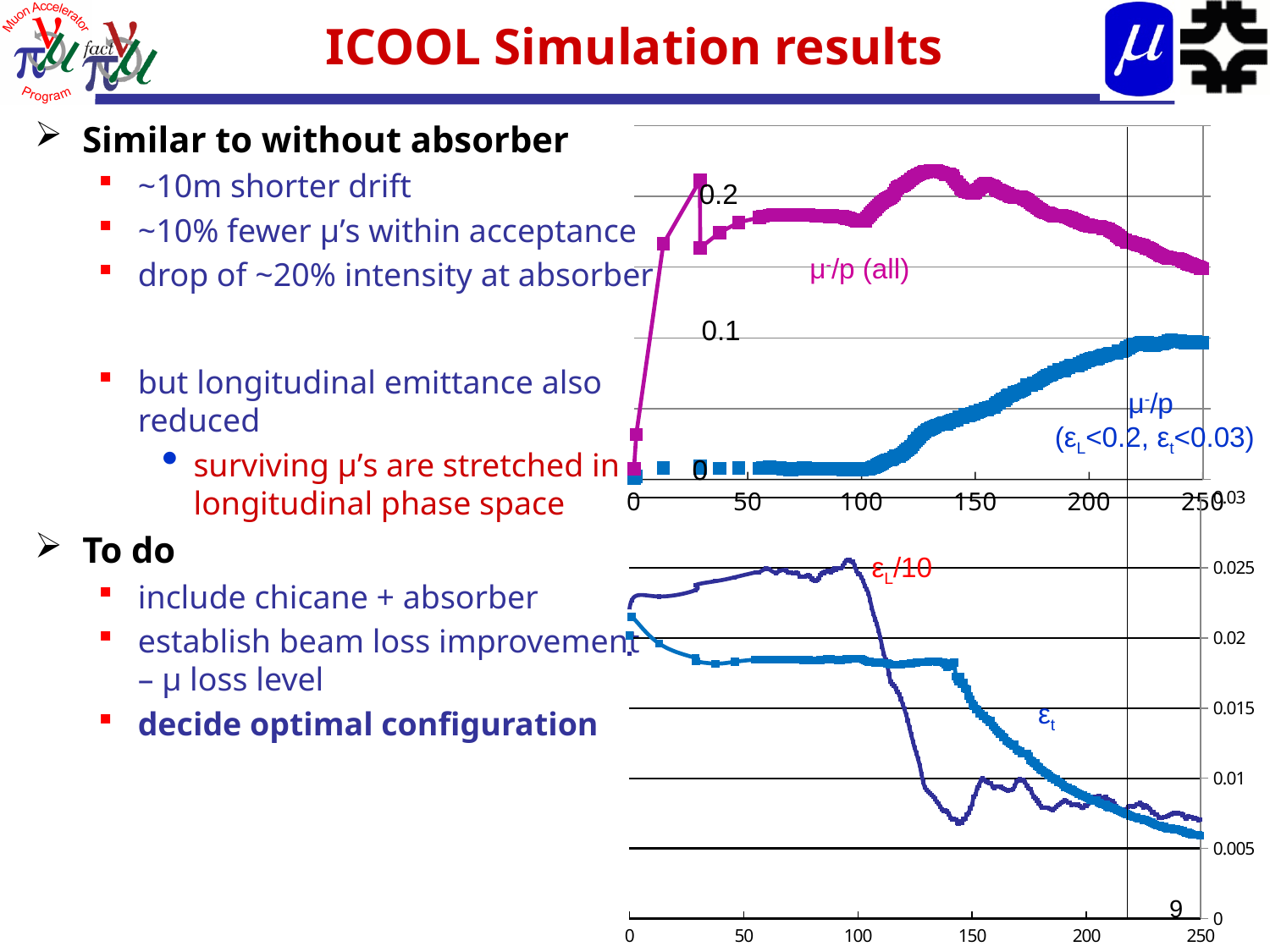
In the top chart, is the value of the μ⁻/p (all) series at x = 250 greater or less than 0.1? greater In the bottom chart, at x = 50, which series has the larger value: εL/10 or εt? εL/10 In the top chart, is the value of the μ⁻/p (εL<0.2, εt<0.03) series at x = 50 greater or less than 0.1? less In the bottom chart, does the εt series rise or fall overall from x = 0 to x = 250? fall In the top chart, at x = 250, which series has the larger value: μ⁻/p (all) or μ⁻/p (εL<0.2, εt<0.03)? μ⁻/p (all) What colour is the μ⁻/p (all) series in the top chart? magenta How many data series are plotted in the top chart? 2 In the top chart, does the μ⁻/p (εL<0.2, εt<0.03) series rise or fall between x = 100 and x = 250? rise In the bottom chart, is the value of the εt series at x = 250 greater or less than 0.01? less What kind of chart is the top chart on the slide? line chart How many data series are plotted in the bottom chart? 2